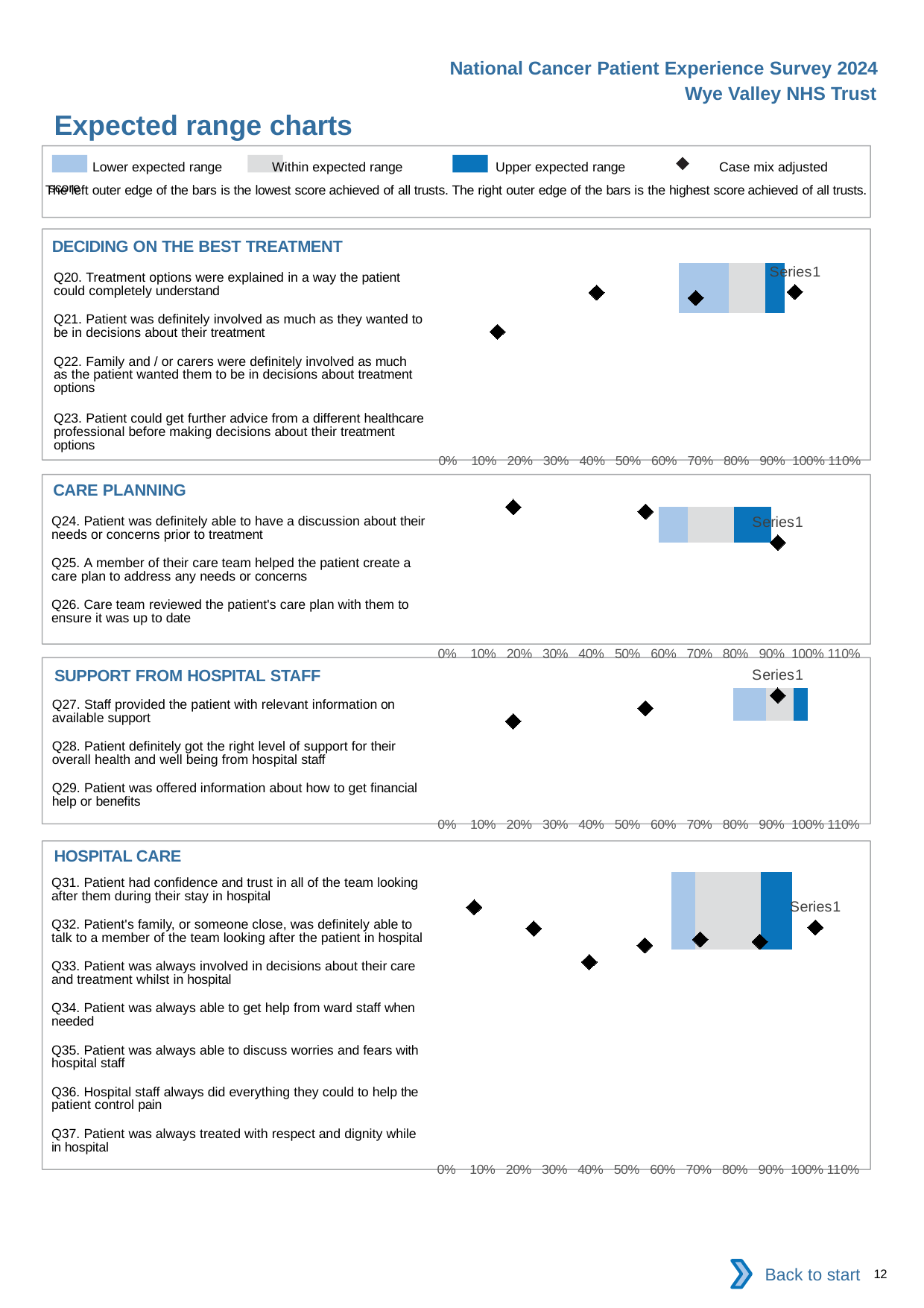
How many questions (categories) are listed in the DECIDING ON THE BEST TREATMENT chart? 4 How many entries does the legend at the top of the slide list? 4 How many questions (categories) are listed in the HOSPITAL CARE chart? 7 How many questions (categories) are listed in the CARE PLANNING chart? 3 What kind of chart is used in the DECIDING ON THE BEST TREATMENT section? bar chart What is the highest tick label on the x axis of the HOSPITAL CARE chart? 110% Which legend entry is represented by the diamond marker? Case mix adjusted score What is the lowest tick label on the x axis of the CARE PLANNING chart? 0%